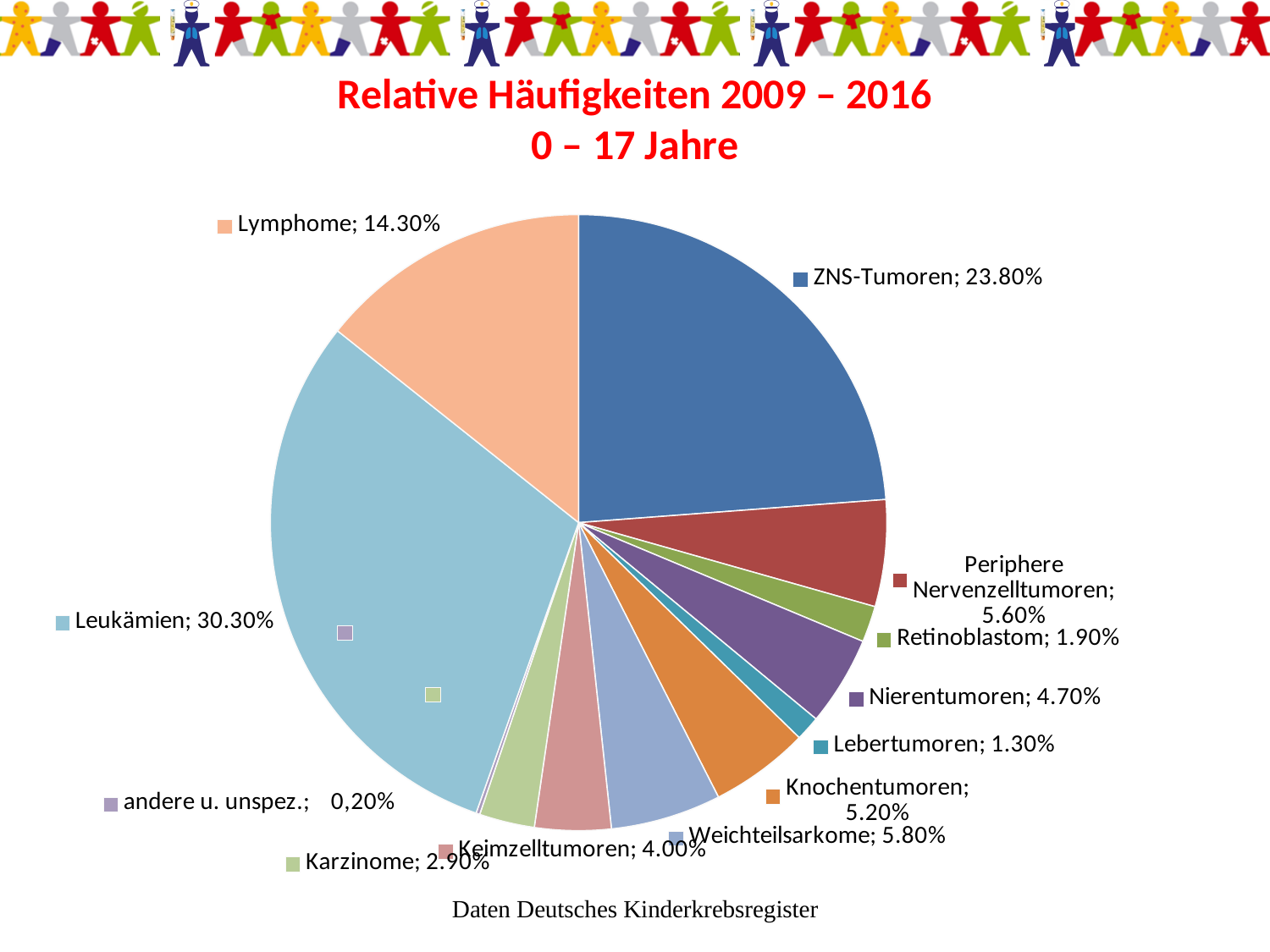
Which is larger, the value for Weichteilsarkome or the value for Knochentumoren? Weichteilsarkome Which category has the smallest share of the pie? andere u. unspez. What is the value for Retinoblastom? 1.90% What is the value for Nierentumoren? 4.70% What is the value for ZNS-Tumoren? 23.80% What is the title of the chart? Relative Häufigkeiten 2009 – 2016 0 – 17 Jahre What is the value for Leukämien? 30.30% How many categories are shown in the pie chart? 12 Which category has the largest share of the pie? Leukämien What is the value for Lymphome? 14.30% What is the difference between the values for Leukämien and ZNS-Tumoren? 6.50% What kind of chart is shown on the slide? pie chart